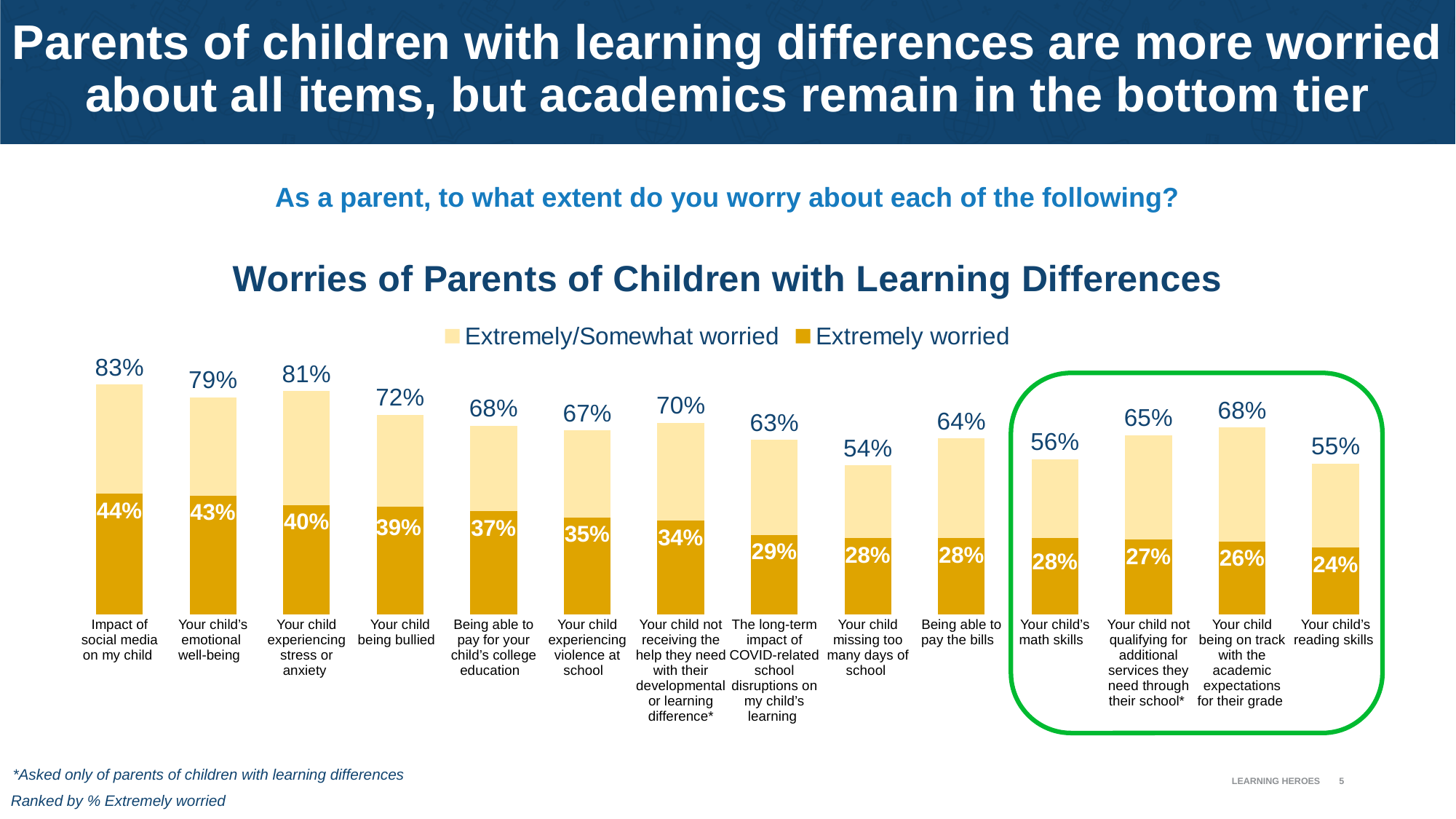
What percentage of parents are extremely worried about the impact of social media on my child? 44% Which has a higher Extremely/Somewhat worried value: 'Your child missing too many days of school' or 'Being able to pay the bills'? Being able to pay the bills Do the Extremely worried values rise or fall from left to right across the chart? Fall What is the Extremely/Somewhat worried value for 'Your child being bullied'? 72% How many series does the legend list? 2 Which item has the lowest Extremely worried percentage? Your child's reading skills Which item has the highest Extremely/Somewhat worried percentage? Impact of social media on my child What is the title of the chart? Worries of Parents of Children with Learning Differences What kind of chart is shown on the slide? Stacked bar chart What percentage of parents are extremely worried about their child's reading skills? 24% How many items are shown on the chart? 14 What is the difference between the Extremely worried percentages for 'Your child's emotional well-being' and 'Your child's math skills'? 15%